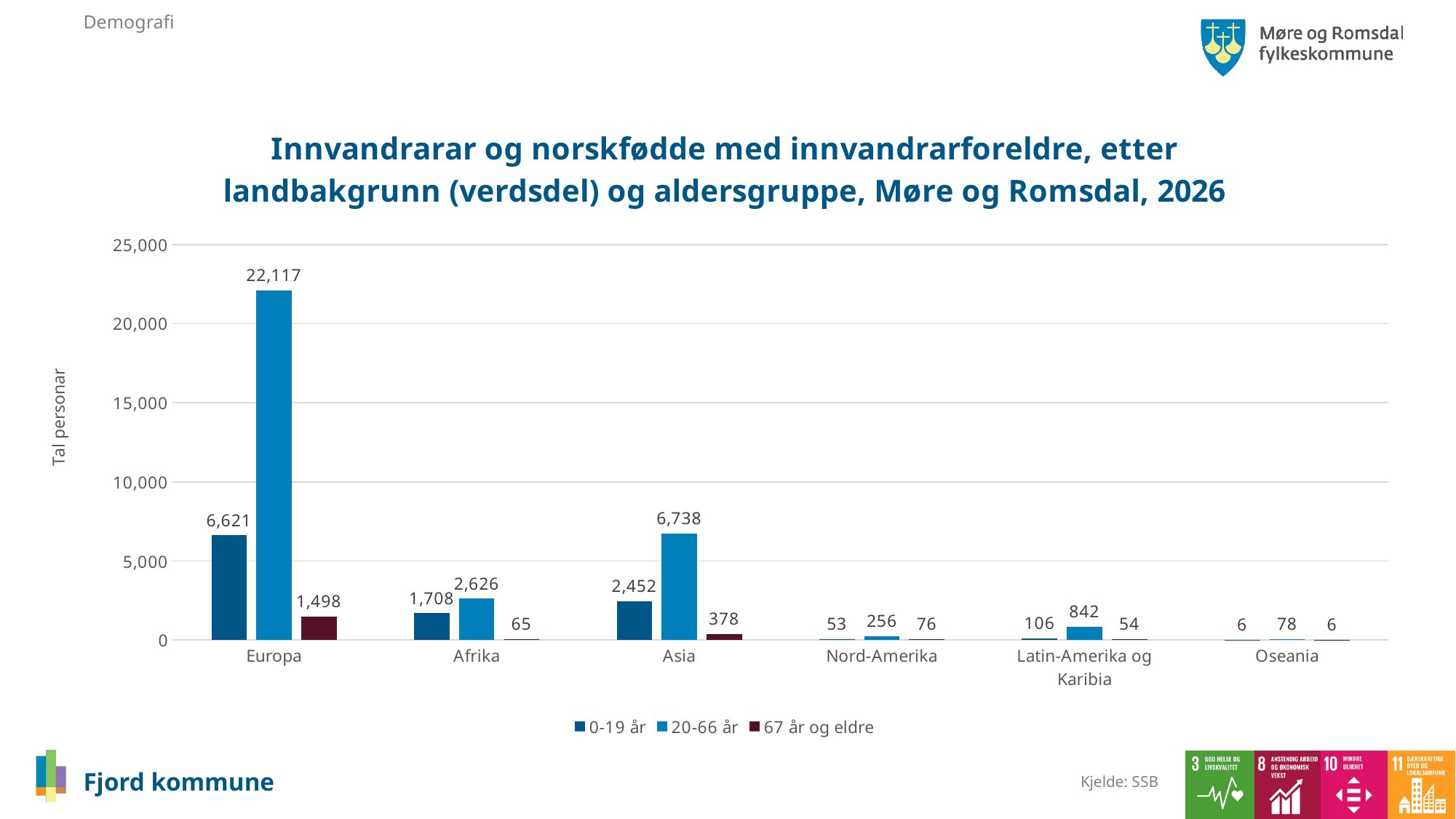
What is the value for the 20-66 år series for Latin-Amerika og Karibia? 842 What kind of chart is shown on the slide? Bar chart What is the label of the y axis? Tal personar How many categories are shown on the x axis? 6 Which is larger: the 0-19 år value for Asia or the 0-19 år value for Afrika? Asia What is the value for the 67 år og eldre series for Afrika? 65 What is the value for the 20-66 år series for Europa? 22,117 What is the difference between the 20-66 år value and the 0-19 år value for Europa? 15,496 What is the value for the 0-19 år series for Asia? 2,452 How many series does the legend list? 3 Which category has the highest value in the 20-66 år series? Europa Which category has the lowest value in the 0-19 år series? Oseania